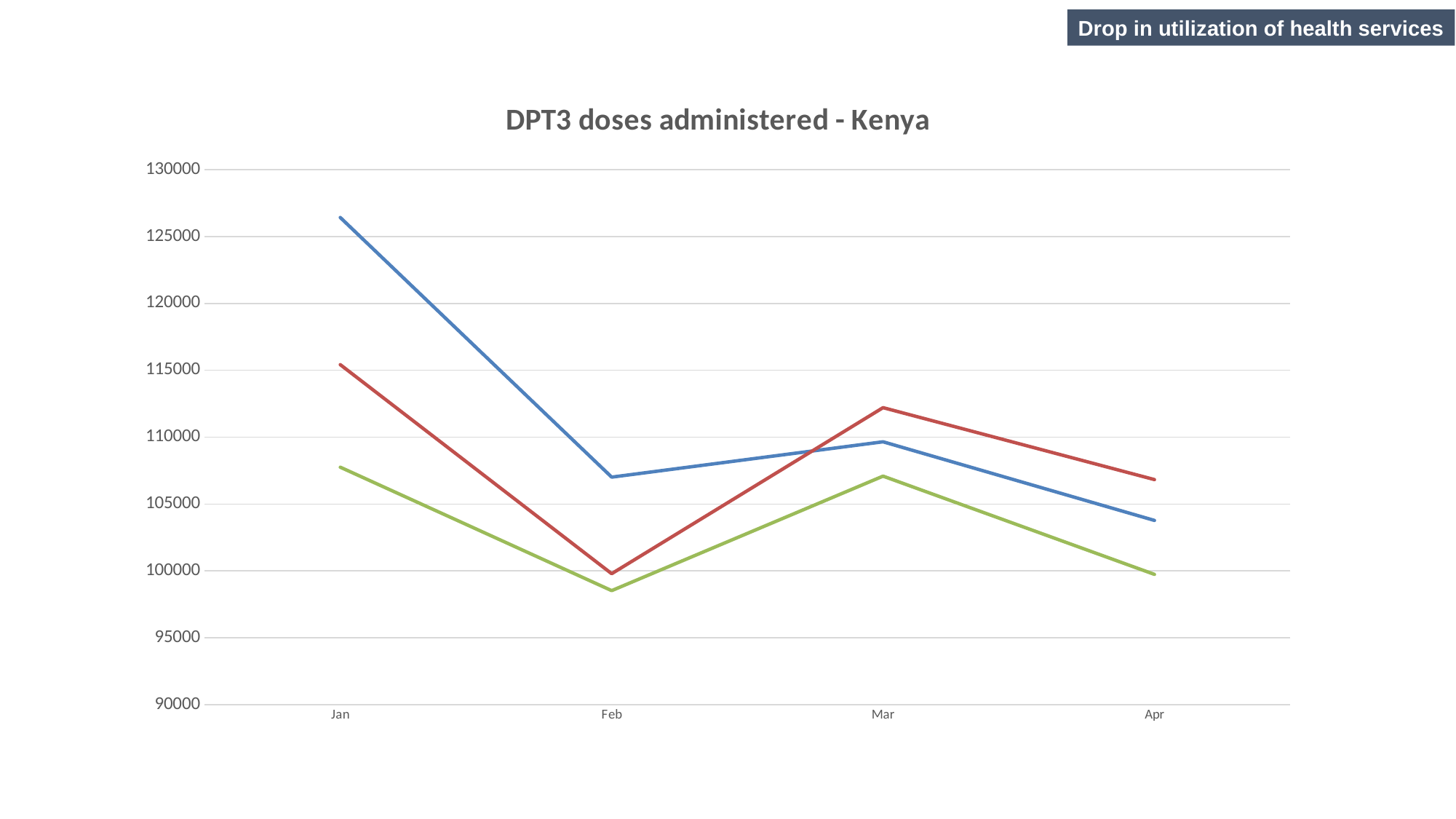
Is the value of the blue line in Jan greater or less than 125000? greater How many lines are plotted on the chart? 3 Is the value of the green line in Feb greater or less than 100000? less What is the title of the chart? DPT3 doses administered - Kenya Is the value of the red line in Apr greater or less than 105000? greater In which month does the blue line reach its highest value? Jan In which month does the green line reach its lowest value? Feb What kind of chart is shown on the slide? line chart How many months are shown on the x axis of the chart? 4 Does the blue line rise or fall from Jan to Feb? fall In Mar, which line is higher, the red line or the blue line? red line